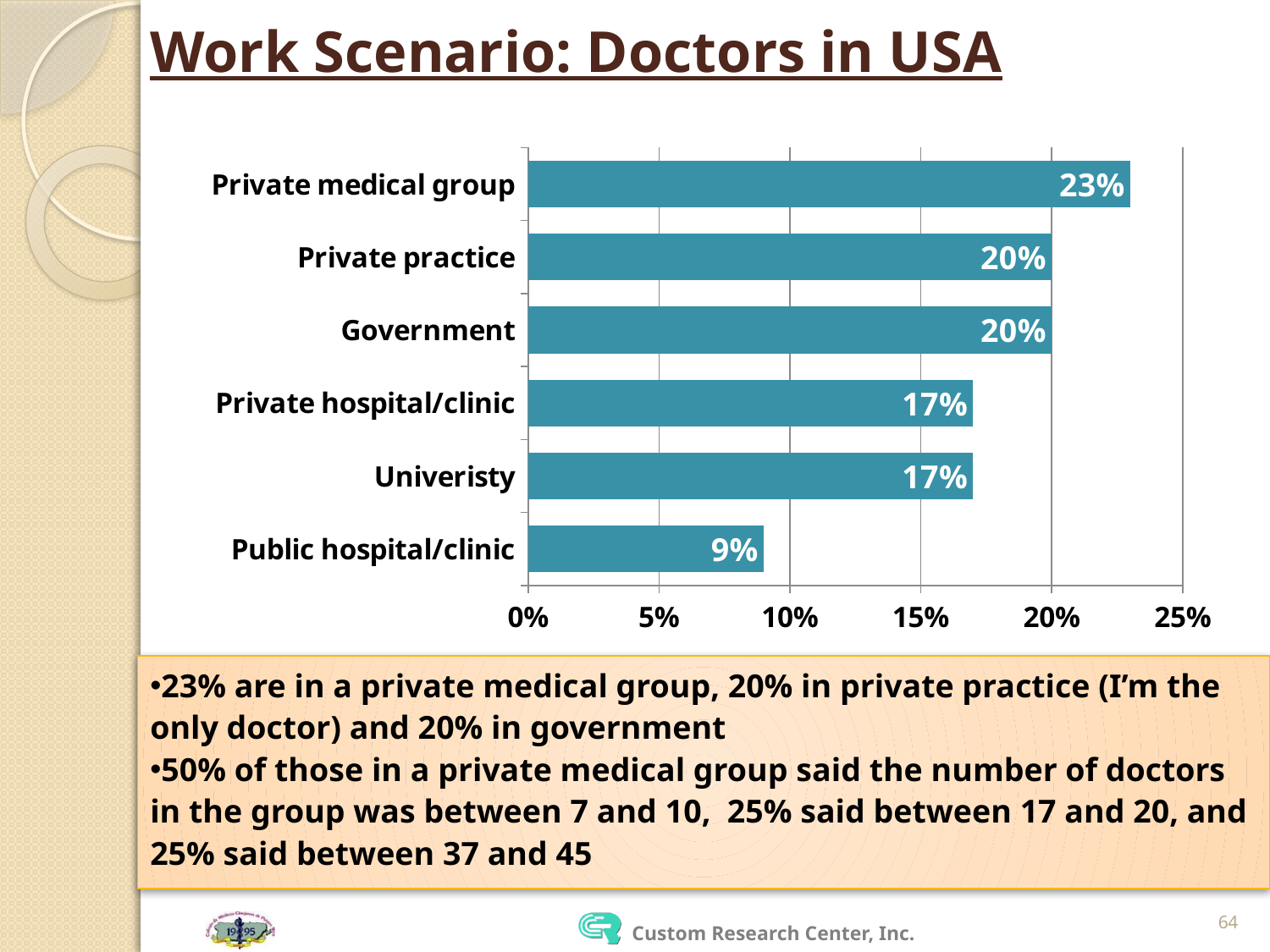
What is the value for Private medical group? 23% What is the value for Government? 20% What kind of chart is shown on the slide? Bar chart What is the value for Public hospital/clinic? 9% Which category has the highest value? Private medical group Which category has the lowest value? Public hospital/clinic What is the difference between the values for Private medical group and Public hospital/clinic? 14% What is the value for Private hospital/clinic? 17% Is the value for Public hospital/clinic greater or less than 10%? less How many categories are shown in the chart? 6 What is the difference between the values for Private practice and Univeristy? 3% Which is larger, the value for Private medical group or the value for Private practice? Private medical group